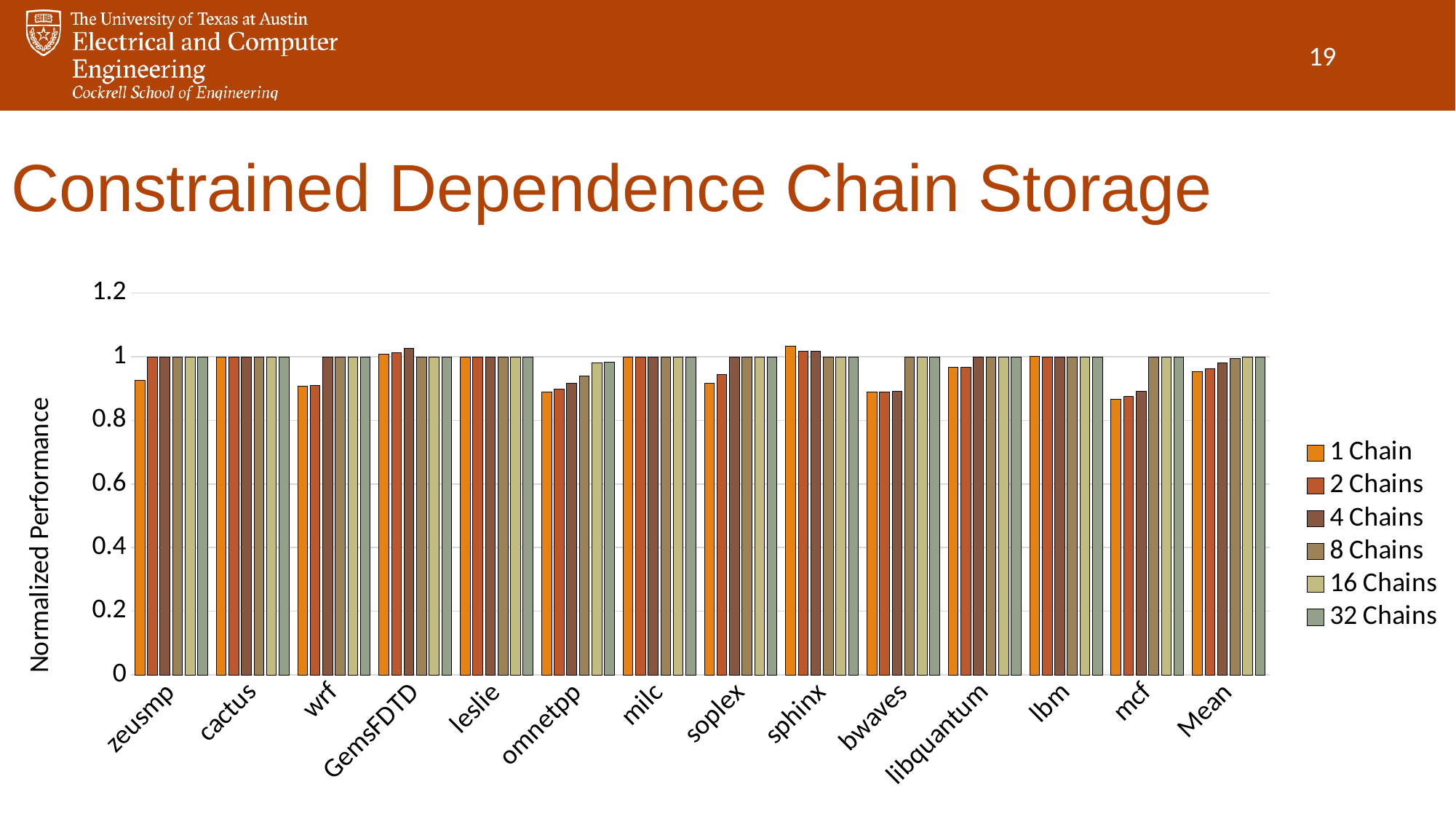
How many benchmark categories (including Mean) are shown on the x axis? 14 Which legend entry is shown in orange? 1 Chain Is the 1 Chain value for bwaves greater or less than 1? less Is the 1 Chain value for mcf greater or less than 0.8? greater How many series does the legend list? 6 What kind of chart is shown on the slide? bar chart Which is larger, the 1 Chain value for zeusmp or the 1 Chain value for cactus? cactus Which benchmark has the lowest 1 Chain value? mcf For omnetpp, do the values rise or fall as the number of chains increases from 1 Chain to 32 Chains? rise Is the 1 Chain value for mcf greater or less than 1? less What is the label of the y axis? Normalized Performance